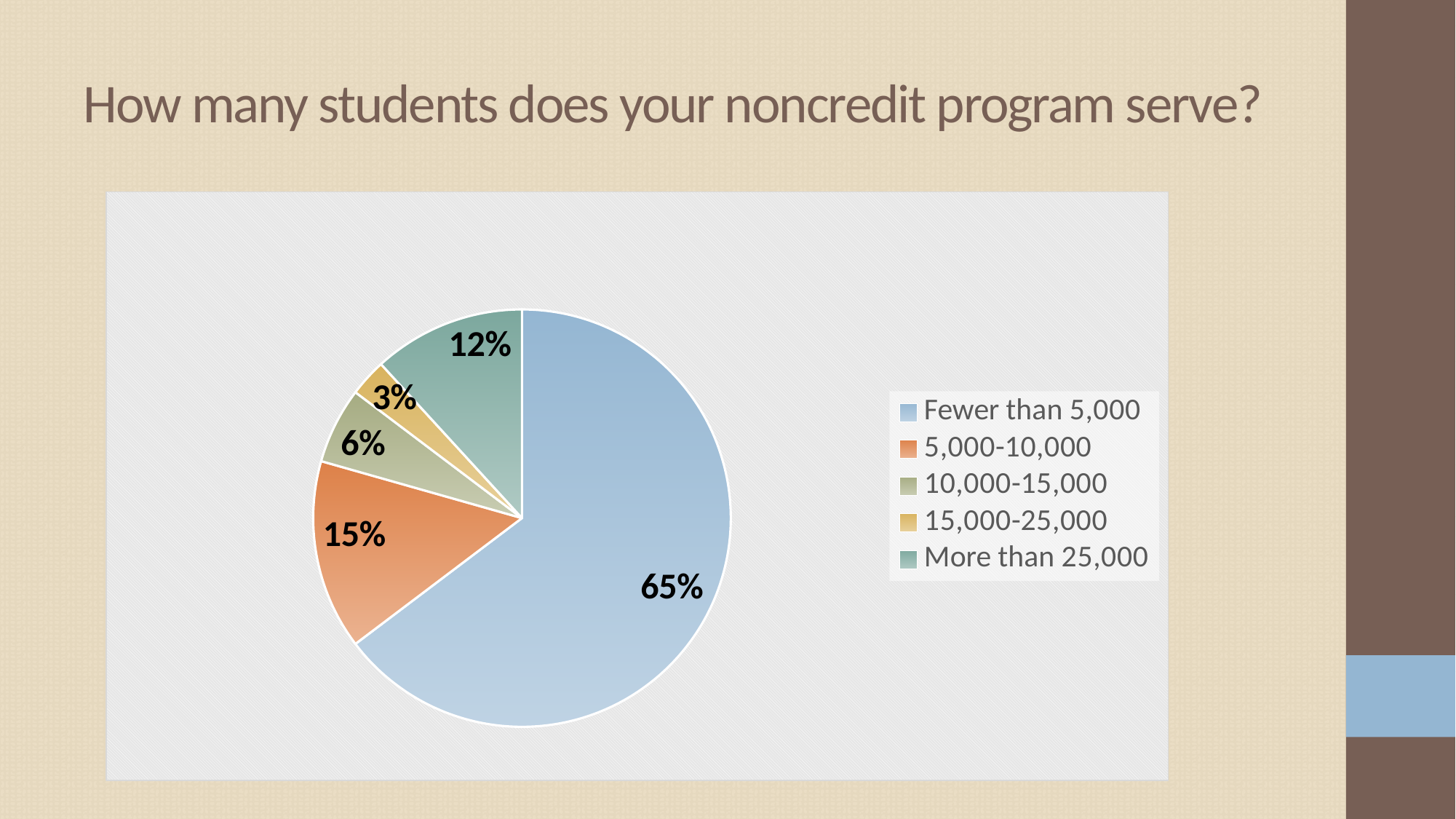
Which category has the largest slice of the pie? Fewer than 5,000 Which is larger, the "More than 25,000" slice or the "10,000-15,000" slice? More than 25,000 Which category has the smallest slice of the pie? 15,000-25,000 How many categories does the legend list? 5 What percentage is shown for the "10,000-15,000" slice? 6% What is the difference in percentage points between the "5,000-10,000" slice and the "More than 25,000" slice? 3 What percentage is shown for the "More than 25,000" slice? 12% What percentage is shown for the "15,000-25,000" slice? 3% What percentage is shown for the "5,000-10,000" slice? 15% What share of the pie is labelled "Fewer than 5,000"? 65% What kind of chart is shown on the slide? pie chart What is the title of the slide containing the chart? How many students does your noncredit program serve?